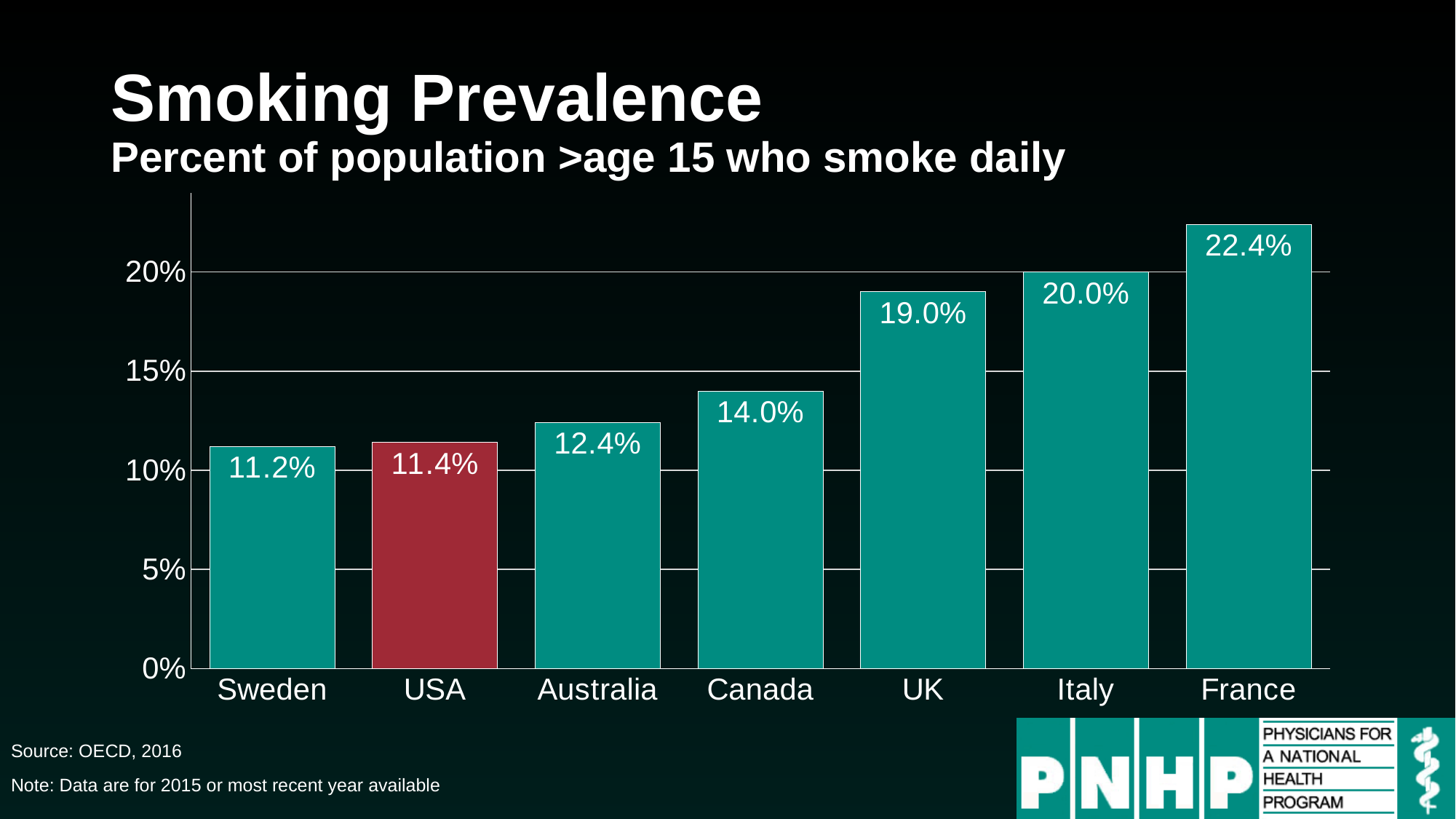
What is the difference in smoking prevalence between France and the USA? 11.0% Which country's bar is shown in a different colour (red) from the others? USA What is the smoking prevalence for the USA? 11.4% How many countries are shown in the chart? 7 Which country has the lowest smoking prevalence? Sweden Is the value for Italy greater or less than 15%? greater Which country has the highest smoking prevalence? France Which has a higher smoking prevalence, Canada or Australia? Canada What is the smoking prevalence for the UK? 19.0% What is the smoking prevalence for Canada? 14.0% What is the difference in smoking prevalence between Italy and Australia? 7.6% What kind of chart is shown on the slide? Bar chart